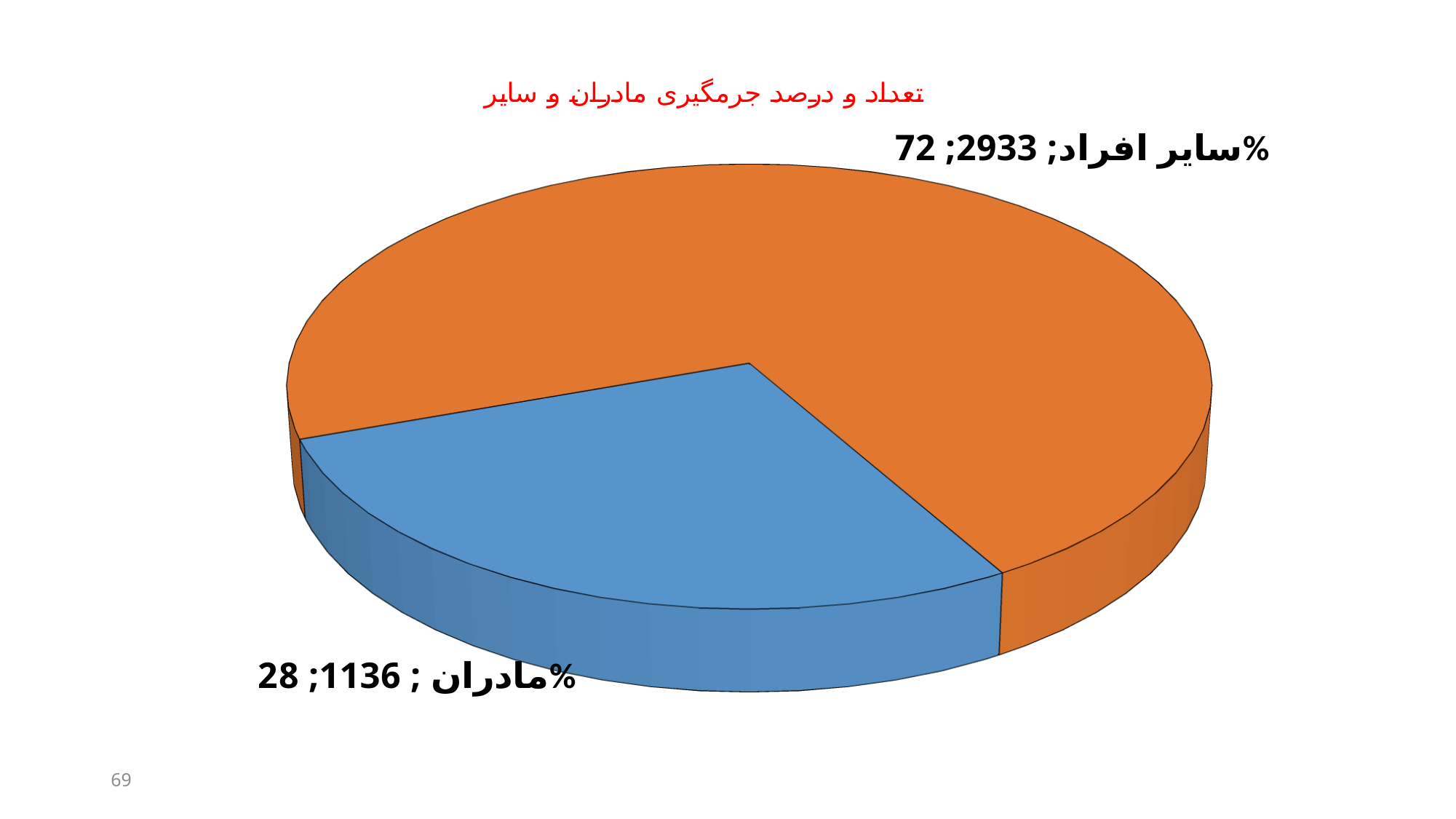
What is the difference between the counts for سایر افراد and مادران? 1797 What is the count shown for مادران? 1136 What is the title of the chart? تعداد و درصد جرمگیری مادران و سایر What is the count shown for سایر افراد? 2933 What percentage share of the pie does سایر افراد have? 72% How many slices does the pie chart have? 2 Which is larger, the count for مادران or the count for سایر افراد? سایر افراد Which category has the largest slice of the pie? سایر افراد What kind of chart is shown on the slide? pie chart What colour is the slice for مادران? blue What percentage share of the pie does مادران have? 28% Which category has the smallest slice of the pie? مادران